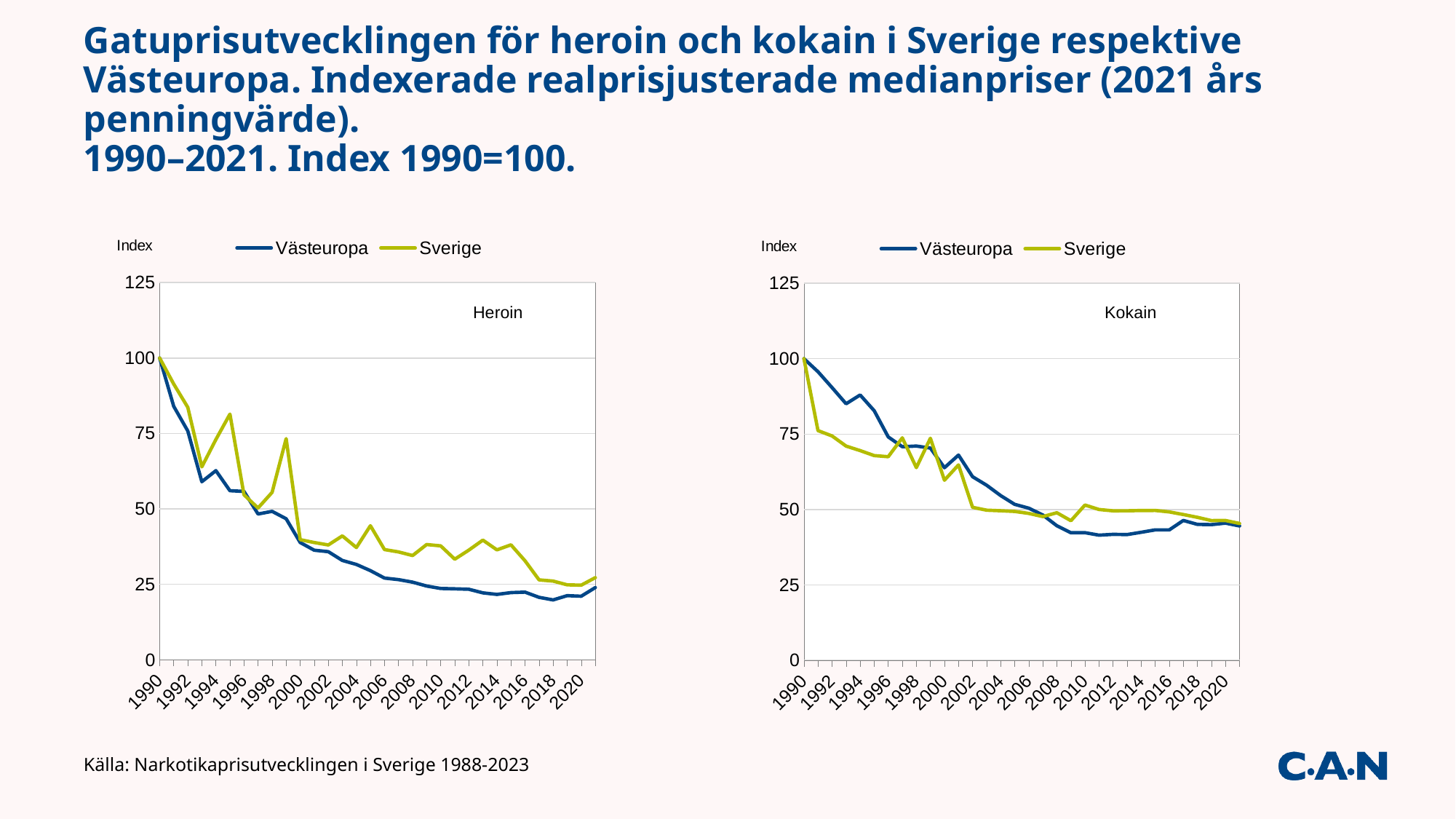
In the Kokain chart, is the value for Västeuropa in 2010 greater or less than 50? less In the Kokain chart, is the value for Västeuropa in 1994 greater or less than 75? greater In the Heroin chart, which series has the higher value in 2005, Västeuropa or Sverige? Sverige In the Kokain chart, which series has the higher value in 1992, Västeuropa or Sverige? Västeuropa In the Heroin chart, is the value for Västeuropa in 2014 greater or less than 25? less In the Kokain chart, what is the index value for Västeuropa in 1990? 100 In the Heroin chart, what is the index value for Sverige in 1990? 100 How many series does the legend of the Kokain chart list? 2 What type of chart is the Heroin chart on the left? Line chart In the Kokain chart, does the Sverige line rise or fall overall from 1990 to 2021? Fall In the Heroin chart, does the Västeuropa line rise or fall overall from 1990 to 2021? Fall